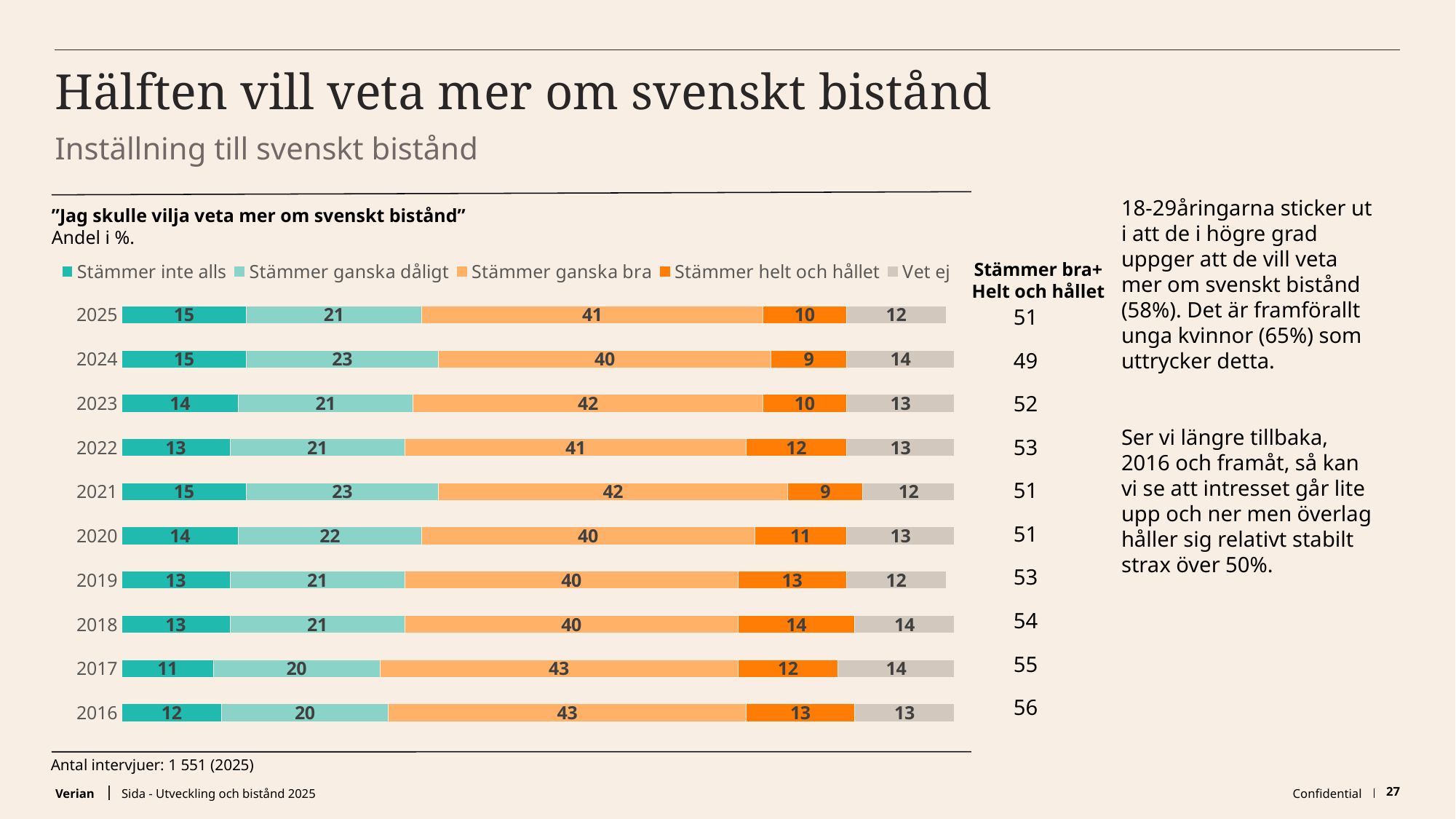
What kind of chart is shown on the slide? Stacked bar chart What is the value for "Stämmer ganska bra" in 2025? 41 What is the value for "Vet ej" in 2024? 14 How many series does the legend list? 5 Which year has the lowest value for "Stämmer inte alls"? 2017 How many years are shown in the chart? 10 What is the value for "Stämmer helt och hållet" in 2018? 14 Which year has the larger value for "Stämmer helt och hållet", 2019 or 2021? 2019 What is the difference between the "Stämmer ganska dåligt" values for 2024 and 2025? 2 Which year has the highest value for "Stämmer helt och hållet"? 2018 What is the difference between the "Stämmer ganska bra" values for 2017 and 2020? 3 What is the value for "Stämmer inte alls" in 2016? 12